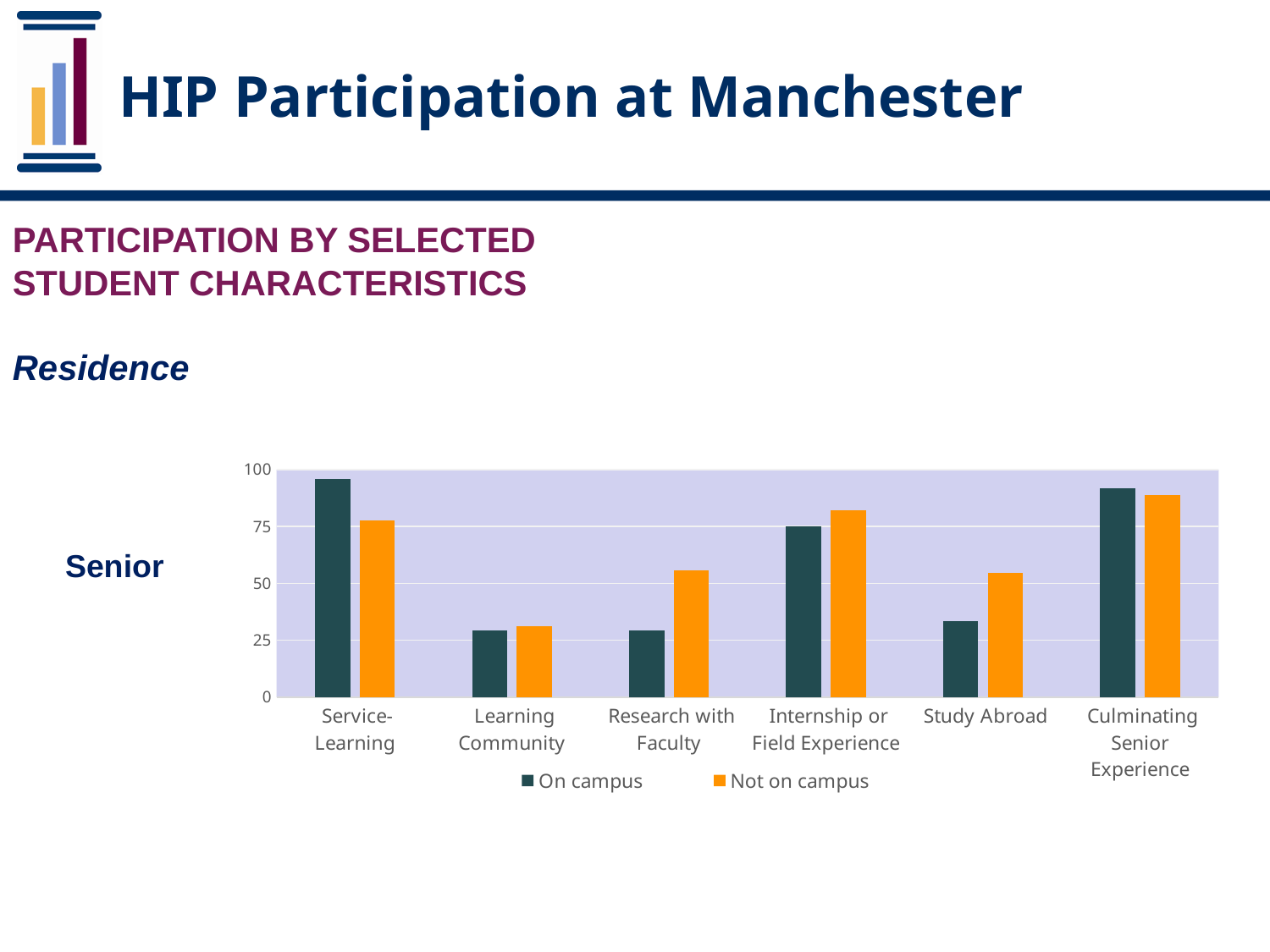
Is the On campus value for Study Abroad greater or less than 50? less Is the On campus value for Service-Learning greater or less than 75? greater What kind of chart is shown on the slide? Bar chart For Study Abroad, which is larger: On campus or Not on campus? Not on campus How many categories are shown along the x axis of the chart? 6 For Service-Learning, which is larger: On campus or Not on campus? On campus Is the Not on campus value for Internship or Field Experience greater or less than 75? greater Which category has the lowest Not on campus value? Learning Community For Research with Faculty, which is larger: On campus or Not on campus? Not on campus How many series does the chart's legend list? 2 Which category has the highest Not on campus value? Culminating Senior Experience What are the two series named in the chart's legend? On campus and Not on campus